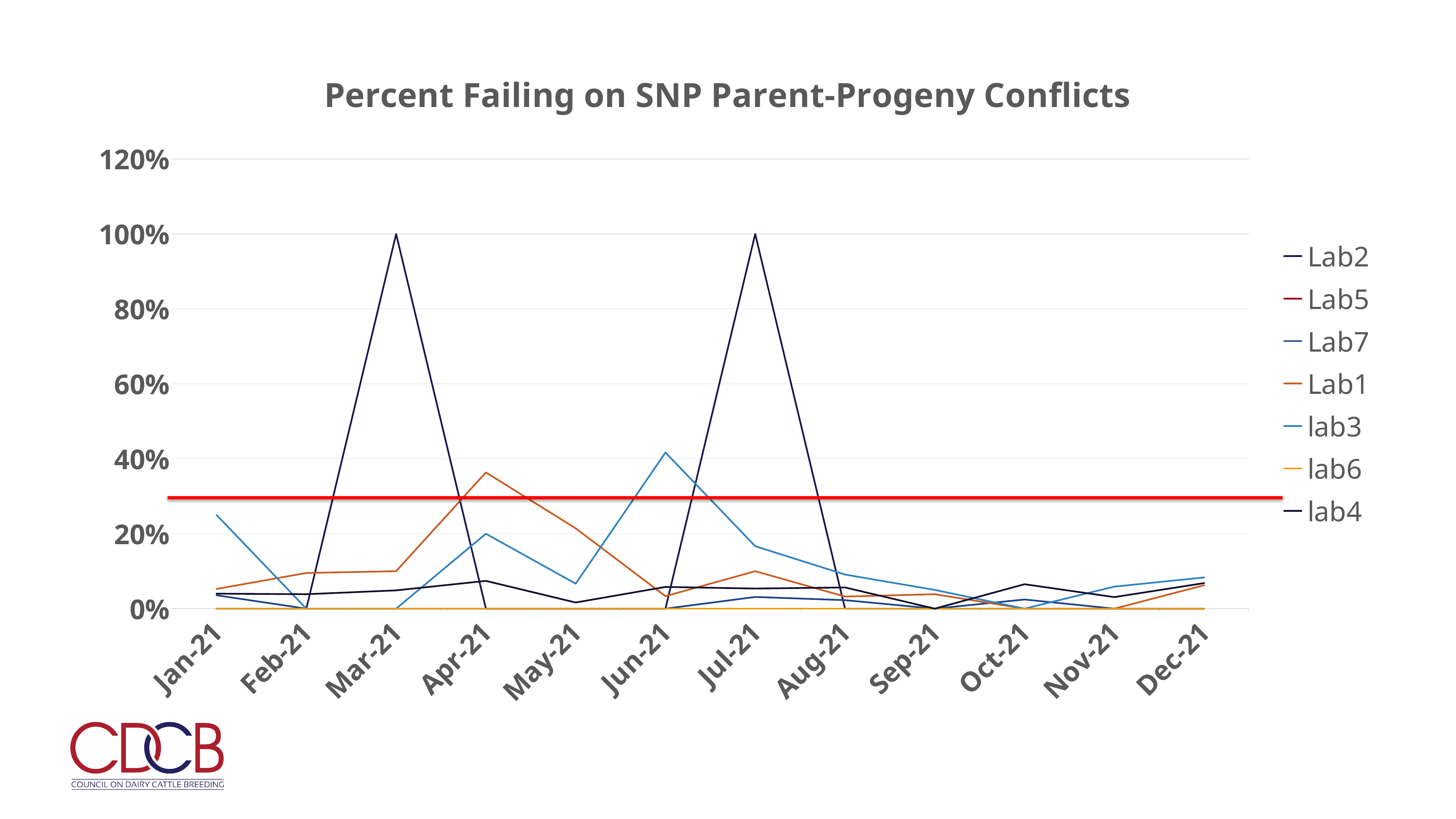
What is the value for Lab2 in Feb-21? 0% What is the value for Lab2 in Jul-21? 100% Is the value for lab3 in Jan-21 greater or less than 20%? greater What is the title of the chart? Percent Failing on SNP Parent-Progeny Conflicts In Mar-21, which is larger, the value for Lab2 or the value for Lab1? Lab2 Which series reaches the highest value on the chart? Lab2 What kind of chart is shown on the slide? line chart How many series does the legend list? 7 What is the value for Lab2 in Mar-21? 100% Is the value for Lab1 in Apr-21 greater or less than 20%? greater Which series is listed first in the legend? Lab2 How many months are plotted along the x axis? 12